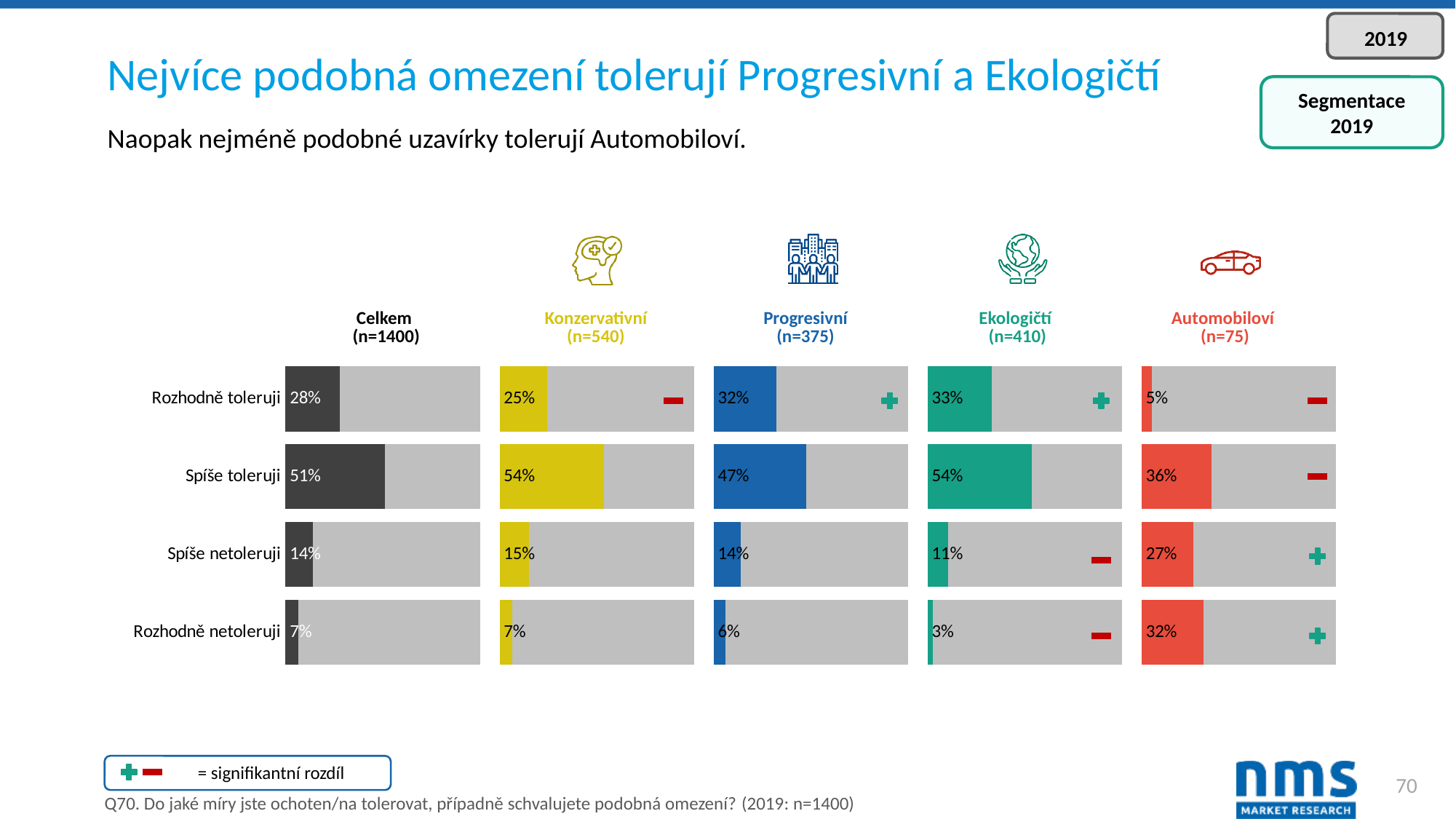
In the Automobiloví (n=75) chart, what is the value for Rozhodně netoleruji? 32% What is the difference between the Rozhodně toleruji values in the Ekologičtí (n=410) chart and the Automobiloví (n=75) chart? 28% In the Ekologičtí (n=410) chart, what is the value for Rozhodně toleruji? 33% In the Ekologičtí (n=410) chart, which category has the lowest value? Rozhodně netoleruji In the Automobiloví (n=75) chart, which category has the lowest value? Rozhodně toleruji In the Celkem (n=1400) chart, what is the value for Spíše toleruji? 51% In the Progresivní (n=375) chart, which category has the highest value? Spíše toleruji How many segment charts (excluding Celkem) are shown on the slide? 4 Which is larger: Spíše netoleruji in the Konzervativní (n=540) chart or Spíše netoleruji in the Automobiloví (n=75) chart? Automobiloví What is the difference between Spíše toleruji and Rozhodně toleruji in the Konzervativní (n=540) chart? 29% What kind of chart is used for the Konzervativní (n=540) column? bar chart How many categories are shown in the Celkem (n=1400) chart? 4